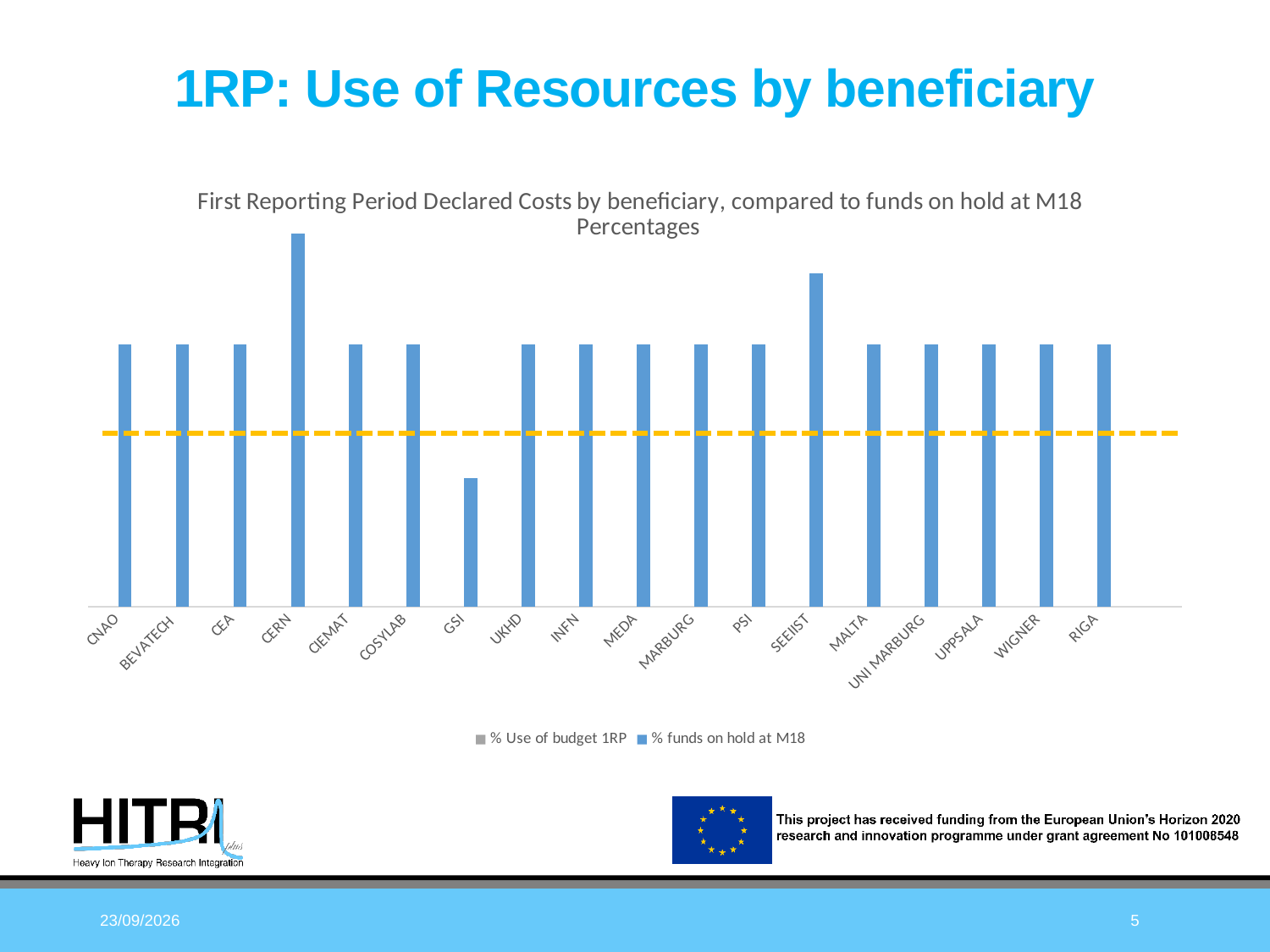
How many beneficiaries are shown on the x axis of the chart? 18 How many series does the chart legend list? 2 What kind of chart is shown on the slide? Bar chart Which beneficiary has the taller bar, GSI or CNAO? CNAO What are the two series named in the chart legend? % Use of budget 1RP and % funds on hold at M18 Which beneficiary's bar is the only one that falls below the dashed line? GSI Which beneficiary has the shortest bar in the chart? GSI Which beneficiary has the taller bar, CERN or SEEIIST? CERN Which beneficiary has the tallest bar in the chart? CERN Which beneficiary has the second tallest bar in the chart? SEEIIST